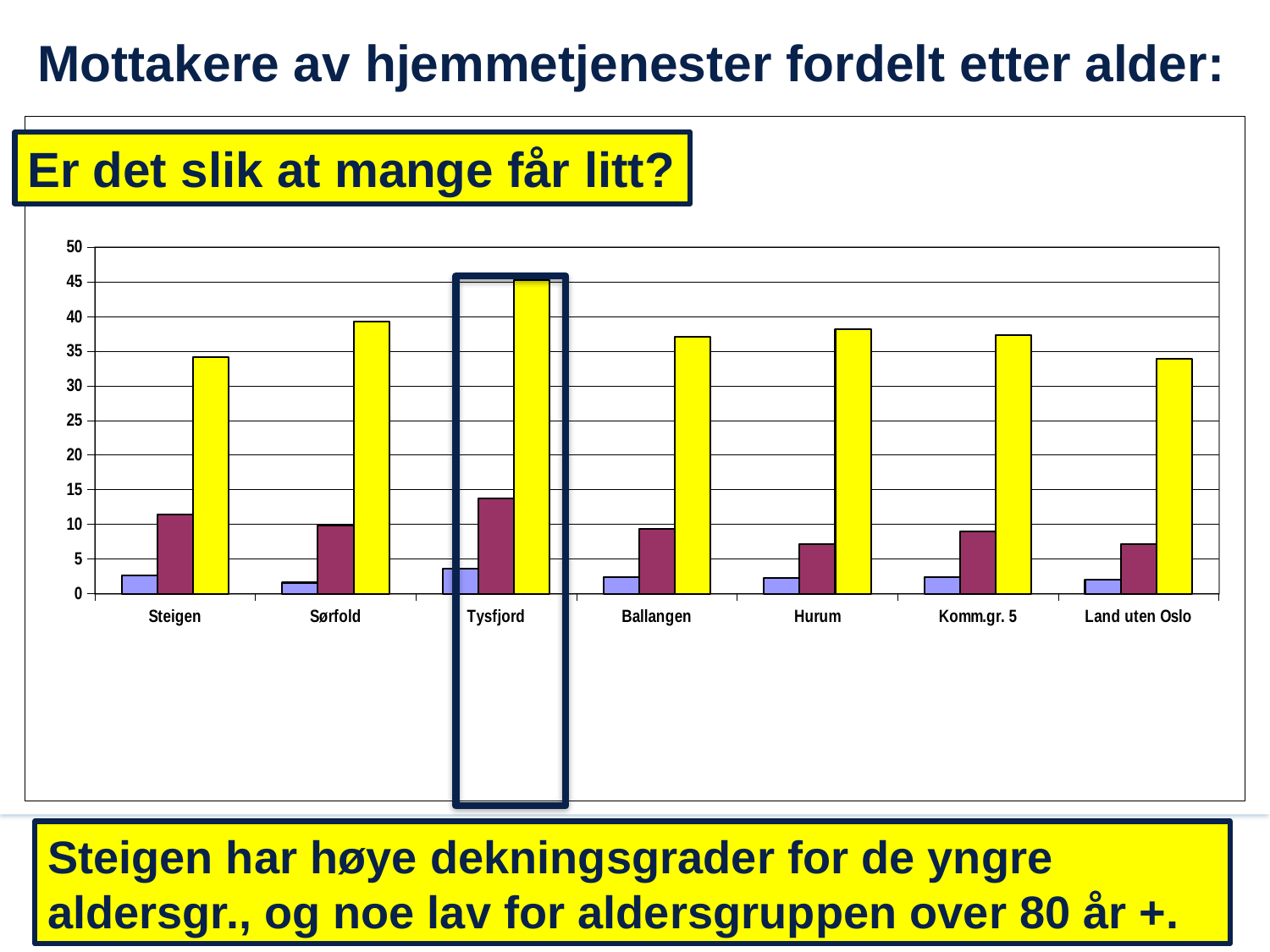
Which category on the chart is highlighted with a dark outlined box? Tysfjord Is the yellow bar for Land uten Oslo greater or less than 40? less Which category has the tallest yellow bar? Tysfjord Is the purple bar for Tysfjord greater or less than 10? greater Which has the taller yellow bar, Sørfold or Steigen? Sørfold How many categories (municipalities/groups) are shown on the x axis? 7 Is the yellow bar for Hurum greater or less than 35? greater Which category has the tallest purple bar? Tysfjord How many bars are plotted for each category? 3 What kind of chart is shown on the slide? bar chart